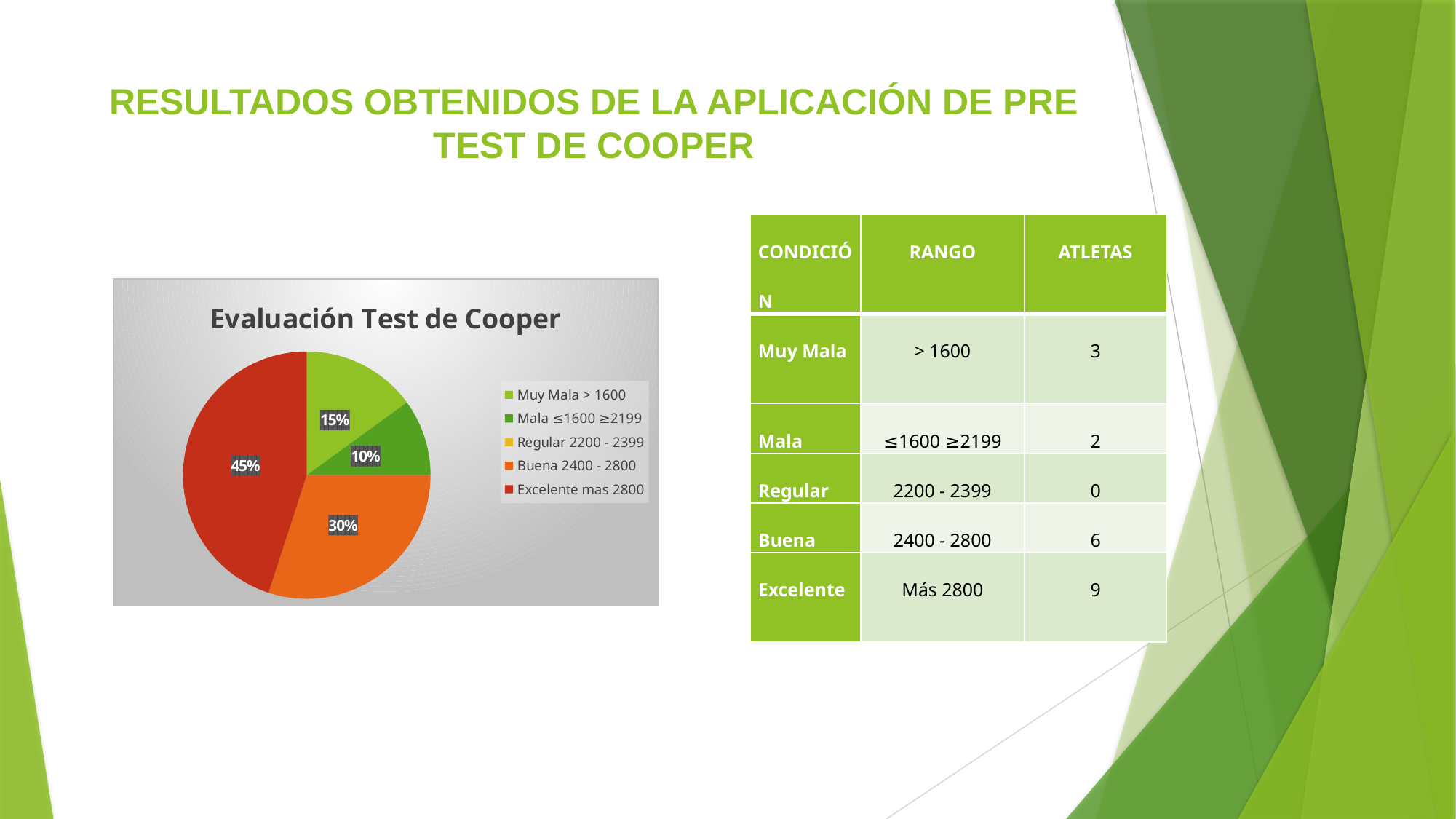
What colour is the Excelente mas 2800 slice in the pie chart? red How many categories does the chart legend list? 5 What percentage of the pie does the Excelente mas 2800 slice represent? 45% What is the value shown for Mala ≤1600 ≥2199 in the pie chart? 10% What is the title of the chart? Evaluación Test de Cooper What type of chart is shown on the slide? pie chart What is the difference between the Excelente mas 2800 slice and the Buena 2400 - 2800 slice? 15% What is the value shown for Muy Mala > 1600 in the pie chart? 15% Which slice is larger, Muy Mala > 1600 or Buena 2400 - 2800? Buena 2400 - 2800 Which category has the largest slice of the pie? Excelente mas 2800 Which labelled slice of the pie is the smallest? Mala ≤1600 ≥2199 What is the value shown for Buena 2400 - 2800 in the pie chart? 30%